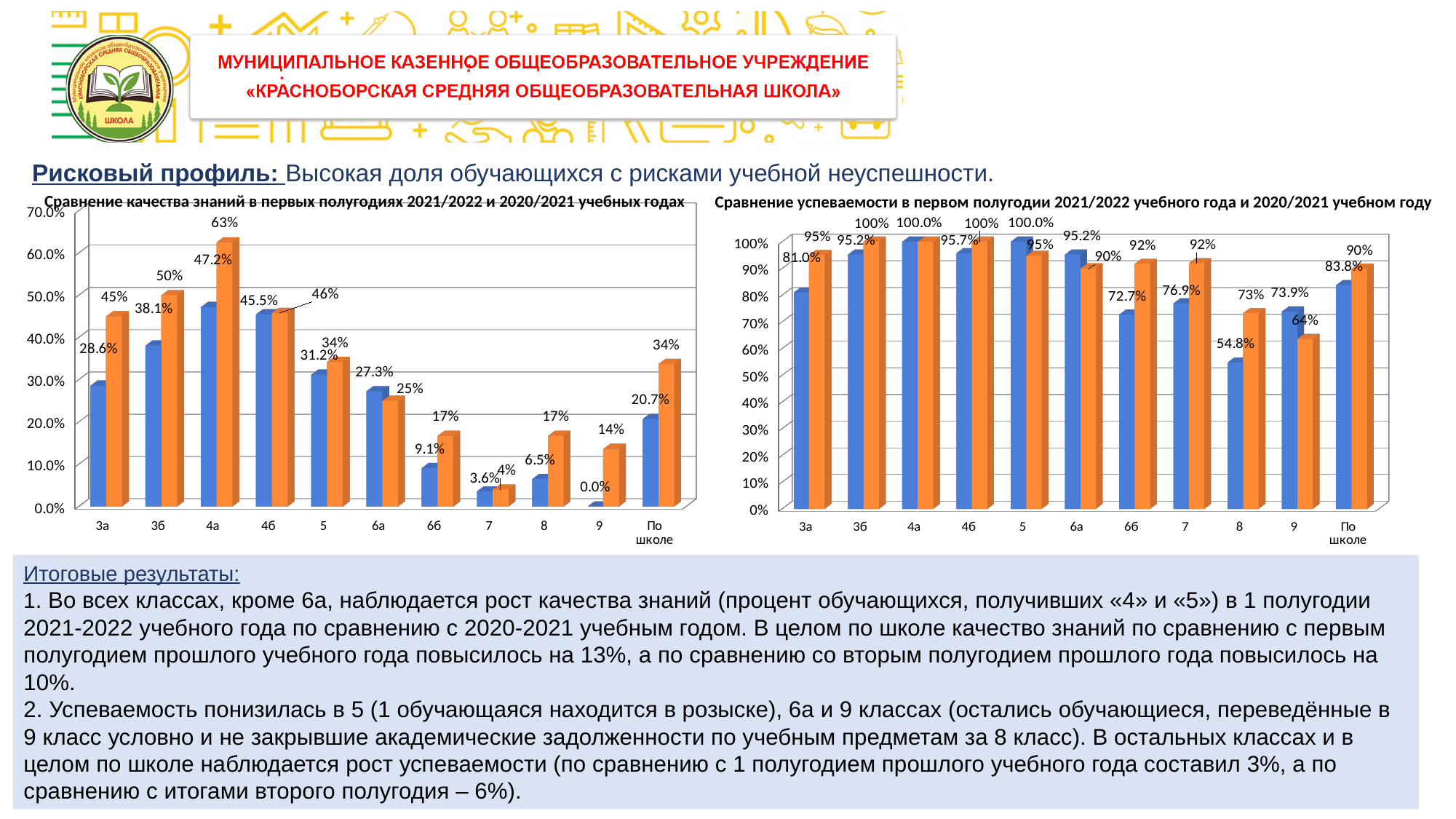
What type of chart is the right chart (Сравнение успеваемости)? bar chart In the right chart (Сравнение успеваемости), which category has the lowest blue bar? 8 In the left chart (Сравнение качества знаний), which category has the highest orange bar? 4а How many categories are shown on the x axis of the left chart (Сравнение качества знаний)? 11 In the left chart (Сравнение качества знаний), which is larger for 6а: the blue bar or the orange bar? the blue bar In the left chart (Сравнение качества знаний), what is the value of the blue bar for 3а? 28.6% In the right chart (Сравнение успеваемости), what is the value of the orange bar for 9? 64% In the left chart (Сравнение качества знаний), which category has the lowest blue bar? 9 In the right chart (Сравнение успеваемости), what is the value of the blue bar for 8? 54.8% In the left chart (Сравнение качества знаний), what is the difference between the orange and blue bars for По школе? 13.3% In the left chart (Сравнение качества знаний), what is the value of the orange bar for 4а? 63% In the right chart (Сравнение успеваемости), what is the difference between the orange and blue bars for 3а? 14%